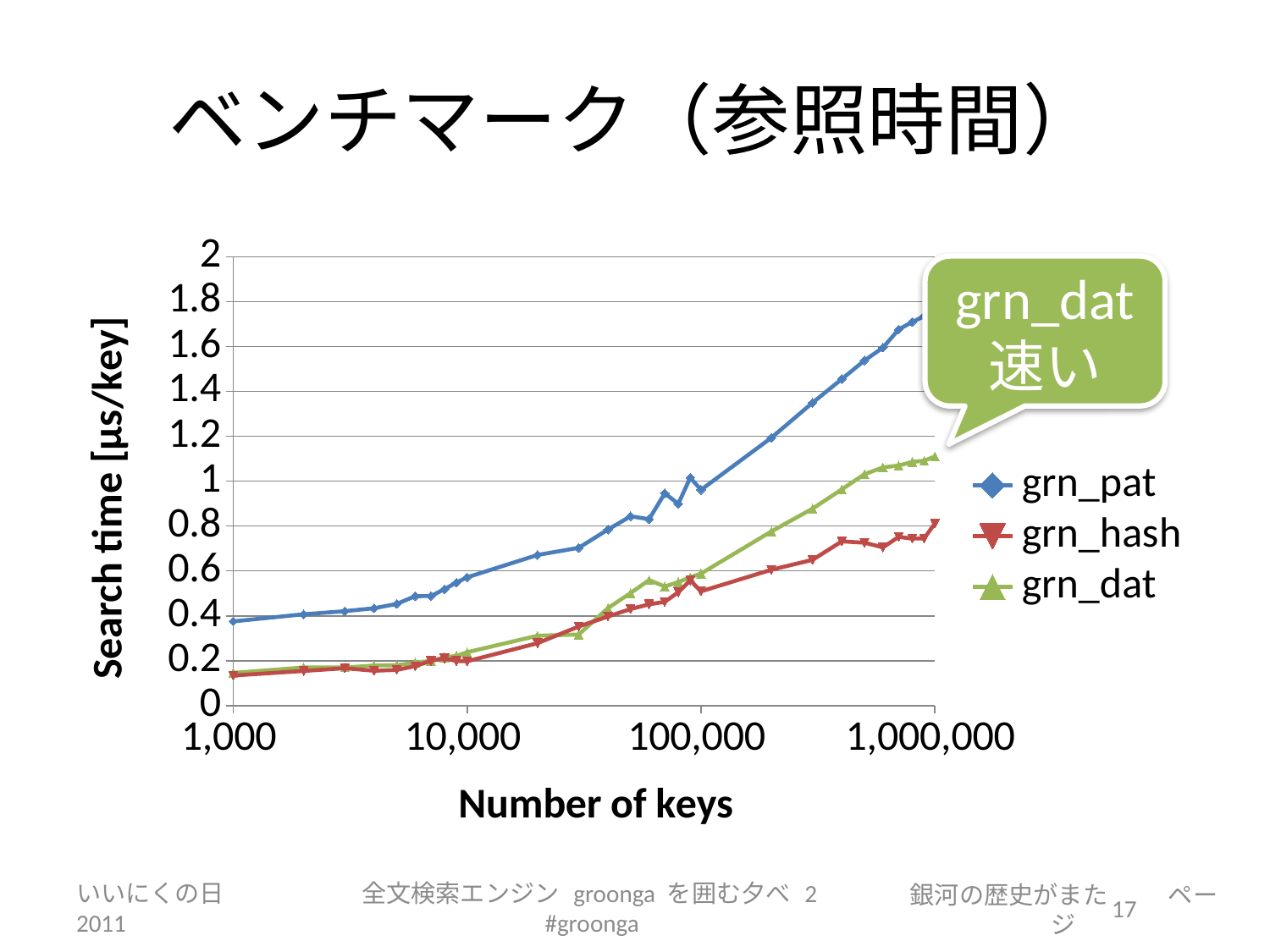
Does the search time for grn_pat rise or fall as the number of keys increases? rise Is the value for grn_dat at 1,000,000 keys greater or less than 1? greater At 1,000,000 keys, which is larger: grn_pat or grn_hash? grn_pat Is the value for grn_hash at 1,000,000 keys greater or less than 1? less Which series has the lowest search time at 1,000,000 keys? grn_hash What is the title of the vertical axis? Search time [µs/key] Which series has the highest search time at 1,000,000 keys? grn_pat Is the value for grn_pat at 1,000,000 keys greater or less than 1.6? greater What kind of chart is shown on the slide? line chart What is the title of the horizontal axis? Number of keys How many series does the legend list? 3